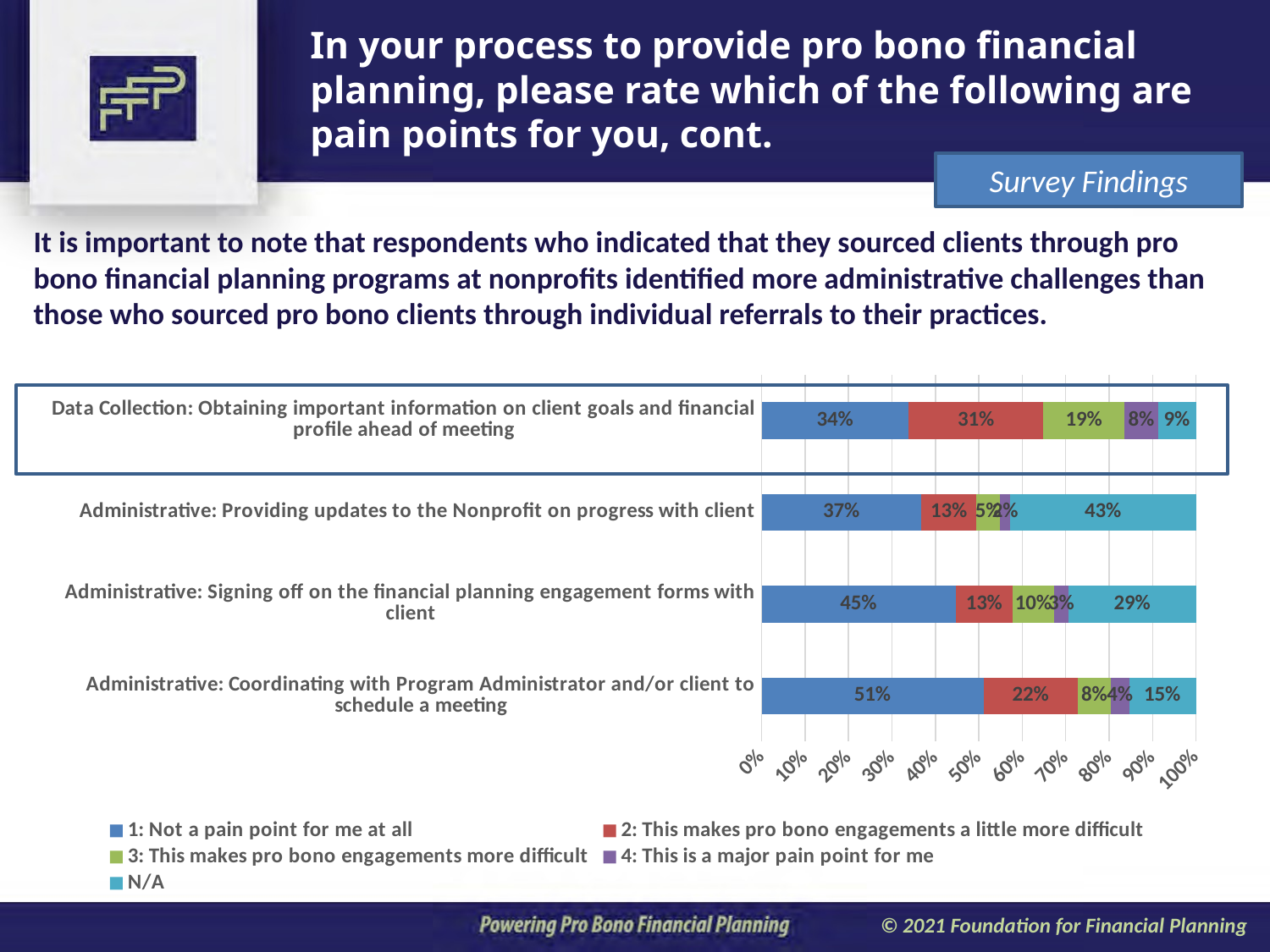
What colour represents the N/A series in the chart? Teal (light blue) Which category has the highest percentage for '1: Not a pain point for me at all'? Administrative: Coordinating with Program Administrator and/or client to schedule a meeting What percentage of respondents rated Data Collection as '3: This makes pro bono engagements more difficult'? 19% Which category has the lowest percentage for '1: Not a pain point for me at all'? Data Collection: Obtaining important information on client goals and financial profile ahead of meeting What type of chart is shown on the slide? Stacked bar chart What percentage of respondents said 'Administrative: Coordinating with Program Administrator and/or client to schedule a meeting' is not a pain point at all? 51% For '2: This makes pro bono engagements a little more difficult', which is larger: the Data Collection category or the Coordinating category? Data Collection What is the N/A percentage for 'Administrative: Signing off on the financial planning engagement forms with client'? 29% How many pain-point categories are plotted in the chart? 4 What is the N/A percentage for 'Administrative: Providing updates to the Nonprofit on progress with client'? 43% What is the difference in the '1: Not a pain point for me at all' percentage between the Coordinating category (51%) and the Data Collection category (34%)? 17 percentage points How many series does the chart legend list? 5